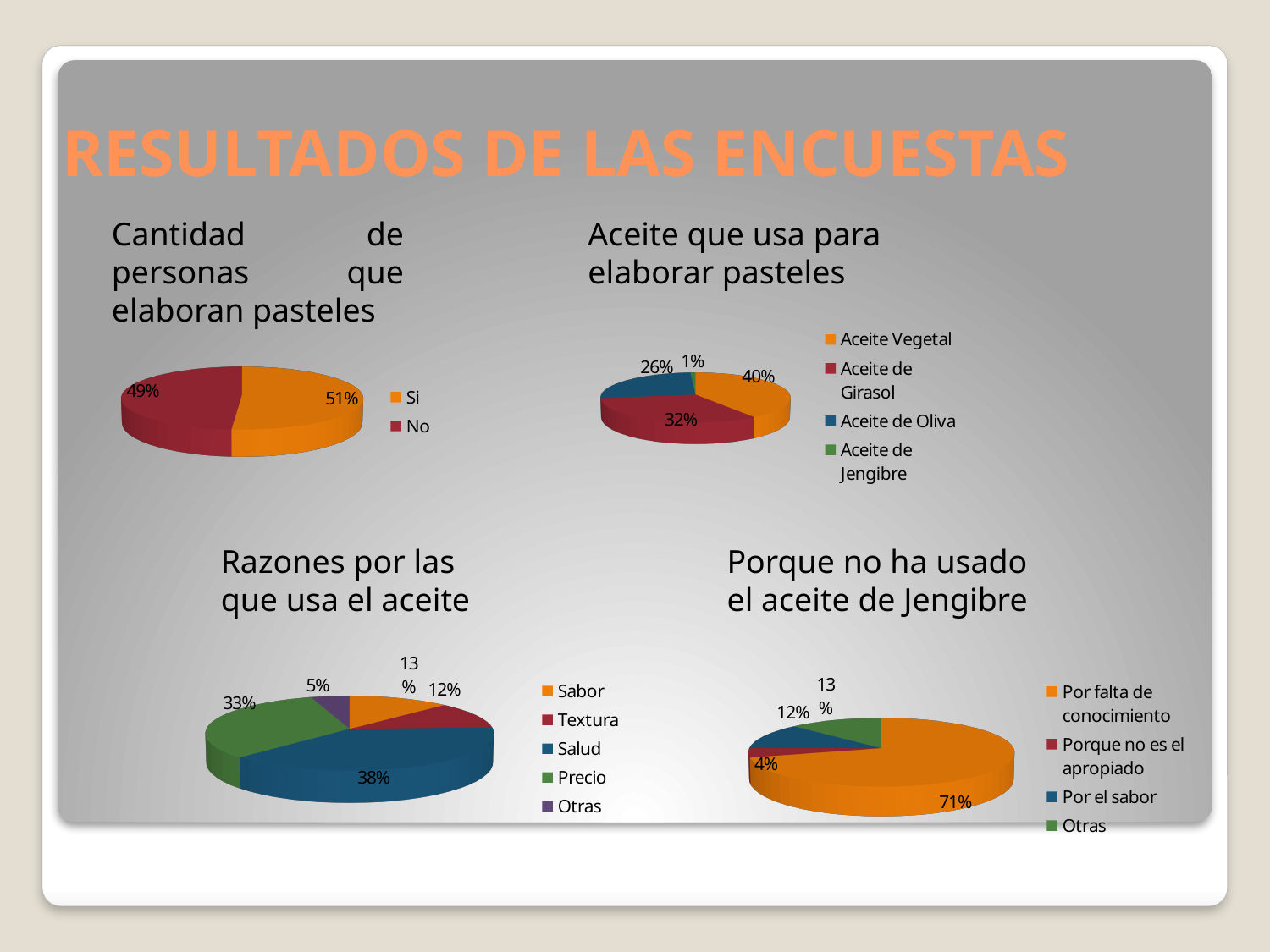
How many categories does the legend of the 'Aceite que usa para elaborar pasteles' chart list? 4 In the 'Aceite que usa para elaborar pasteles' chart, what is the difference between the shares of Aceite Vegetal and Aceite de Oliva? 14% In the 'Porque no ha usado el aceite de Jengibre' chart, which reason has the smallest share? Porque no es el apropiado In the 'Razones por las que usa el aceite' chart, which reason has the largest share? Salud In the 'Aceite que usa para elaborar pasteles' chart, which oil has the smallest share? Aceite de Jengibre In the 'Razones por las que usa el aceite' chart, what percentage is shown for Salud? 38% In the 'Aceite que usa para elaborar pasteles' chart, what percentage is shown for Aceite Vegetal? 40% In the 'Cantidad de personas que elaboran pasteles' chart, what percentage is shown for 'No'? 49% What type of chart is used for 'Cantidad de personas que elaboran pasteles'? Pie chart In the 'Cantidad de personas que elaboran pasteles' chart, what percentage is shown for 'Si'? 51% In the 'Razones por las que usa el aceite' chart, which is larger, Precio or Otras? Precio In the 'Porque no ha usado el aceite de Jengibre' chart, what percentage is shown for 'Por falta de conocimiento'? 71%